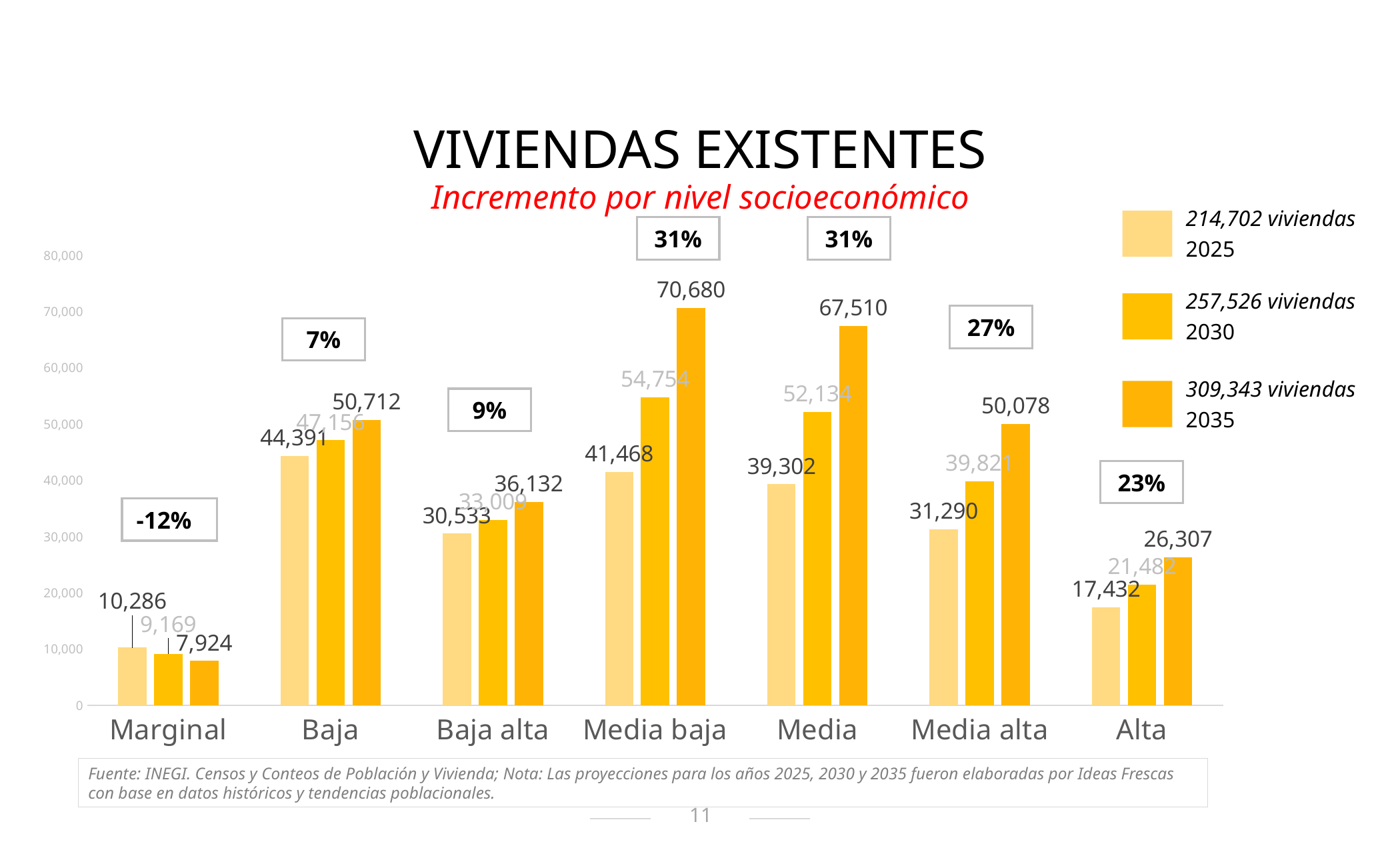
What is the 2035 value for Media baja? 70,680 Which category has the highest 2035 value? Media baja What is the 2030 value for Alta? 21,482 How many socioeconomic categories are shown on the x axis? 7 How many series does the legend list? 3 Do the values for Marginal rise or fall from 2025 to 2035? fall What is the 2025 value for Baja? 44,391 Which category has the lowest 2025 value? Marginal What kind of chart is shown on the slide? bar chart What is the difference between the 2035 and 2025 values for Media baja? 29,212 Which is larger: the 2035 value for Media or the 2035 value for Media alta? Media What percentage increase is shown in the box above the Media alta bars? 27%